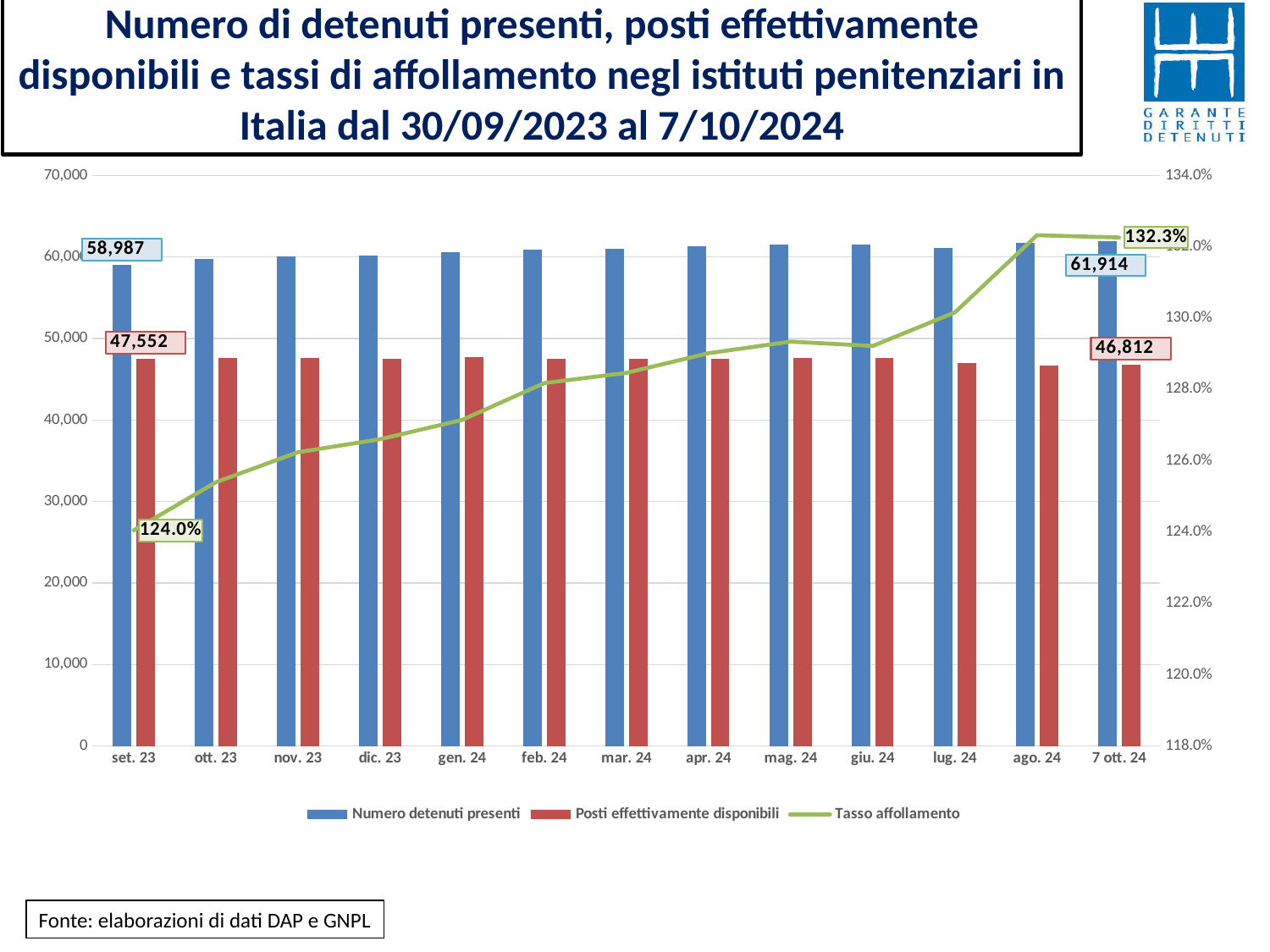
Does the Tasso affollamento line generally rise or fall from set. 23 to 7 ott. 24? rise Is the value of Numero detenuti presenti for mar. 24 greater or less than 50,000? greater How many series does the legend list? 3 Which period has the lowest Tasso affollamento? set. 23 What is the value of Numero detenuti presenti for set. 23? 58,987 In set. 23, how much larger is Numero detenuti presenti than Posti effettivamente disponibili? 11,435 What is the Tasso affollamento for set. 23? 124.0% What is the difference between Posti effettivamente disponibili in set. 23 and in 7 ott. 24? 740 How many time periods are shown on the x axis? 13 What is the Tasso affollamento for 7 ott. 24? 132.3% What is the value of Posti effettivamente disponibili for 7 ott. 24? 46,812 By how much did Numero detenuti presenti increase from set. 23 to 7 ott. 24? 2,927